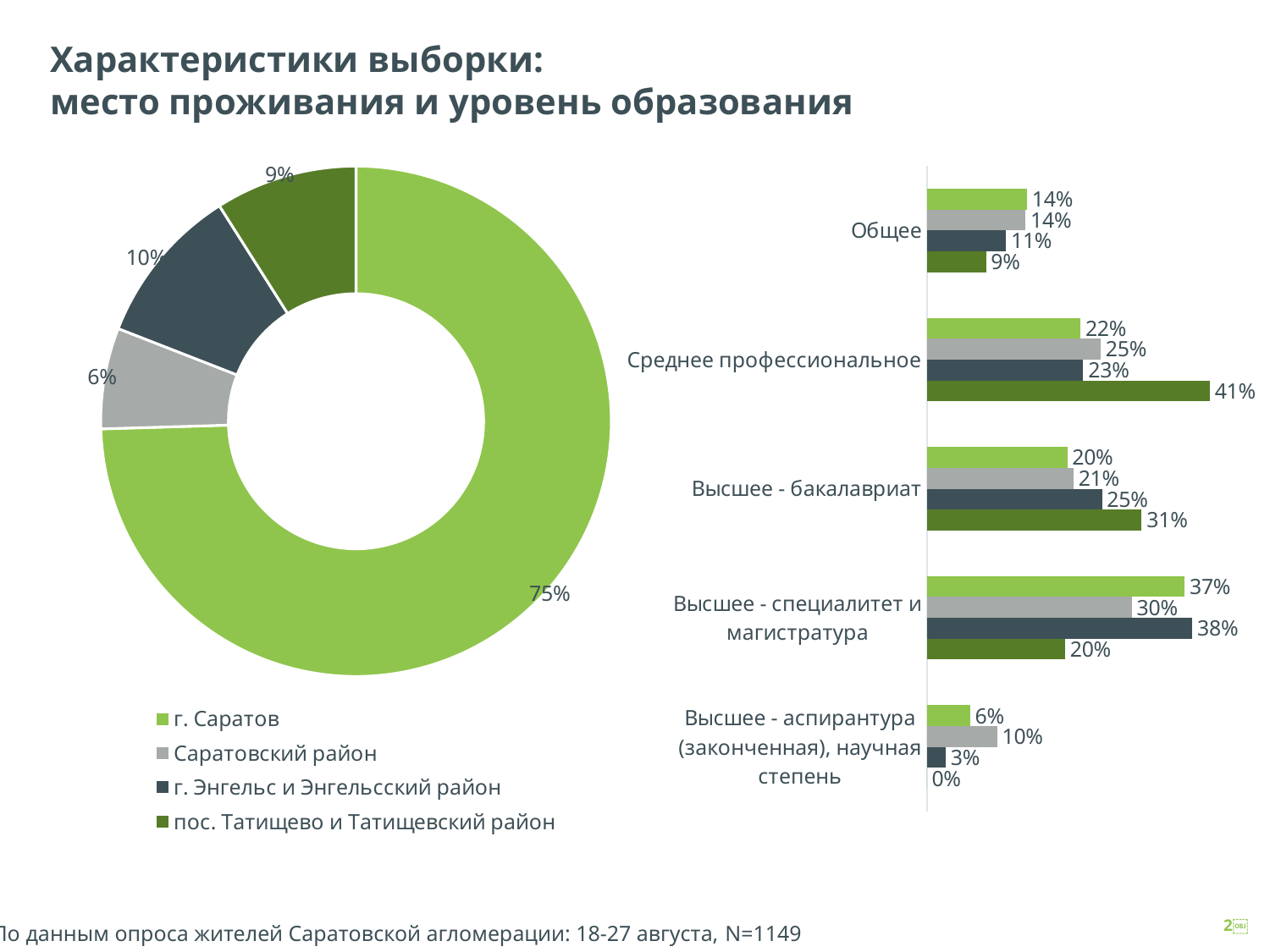
In the right bar chart, how many education categories are shown on the axis? 5 In the right bar chart, what is the value for пос. Татищево и Татищевский район in the category Высшее - аспирантура (законченная), научная степень? 0% In the right bar chart, what is the difference between the г. Энгельс и Энгельсский район value (38%) and the пос. Татищево и Татищевский район value (20%) for Высшее - специалитет и магистратура? 18% How many categories does the legend of the left pie chart list? 4 In the left pie chart, what share is shown for г. Саратов? 75% In the left pie chart, which category has the smallest share? Саратовский район In the right bar chart, which is larger for Высшее - бакалавриат: the value for г. Саратов or the value for пос. Татищево и Татищевский район? пос. Татищево и Татищевский район In the left pie chart, what share is shown for Саратовский район? 6% What kind of chart is the right chart on the slide? bar chart What kind of chart is the left chart on the slide? pie chart (donut) In the right bar chart, what is the value for г. Саратов (light green) in the category Высшее - специалитет и магистратура? 37% In the right bar chart, what is the value for пос. Татищево и Татищевский район (dark green) in the category Среднее профессиональное? 41%